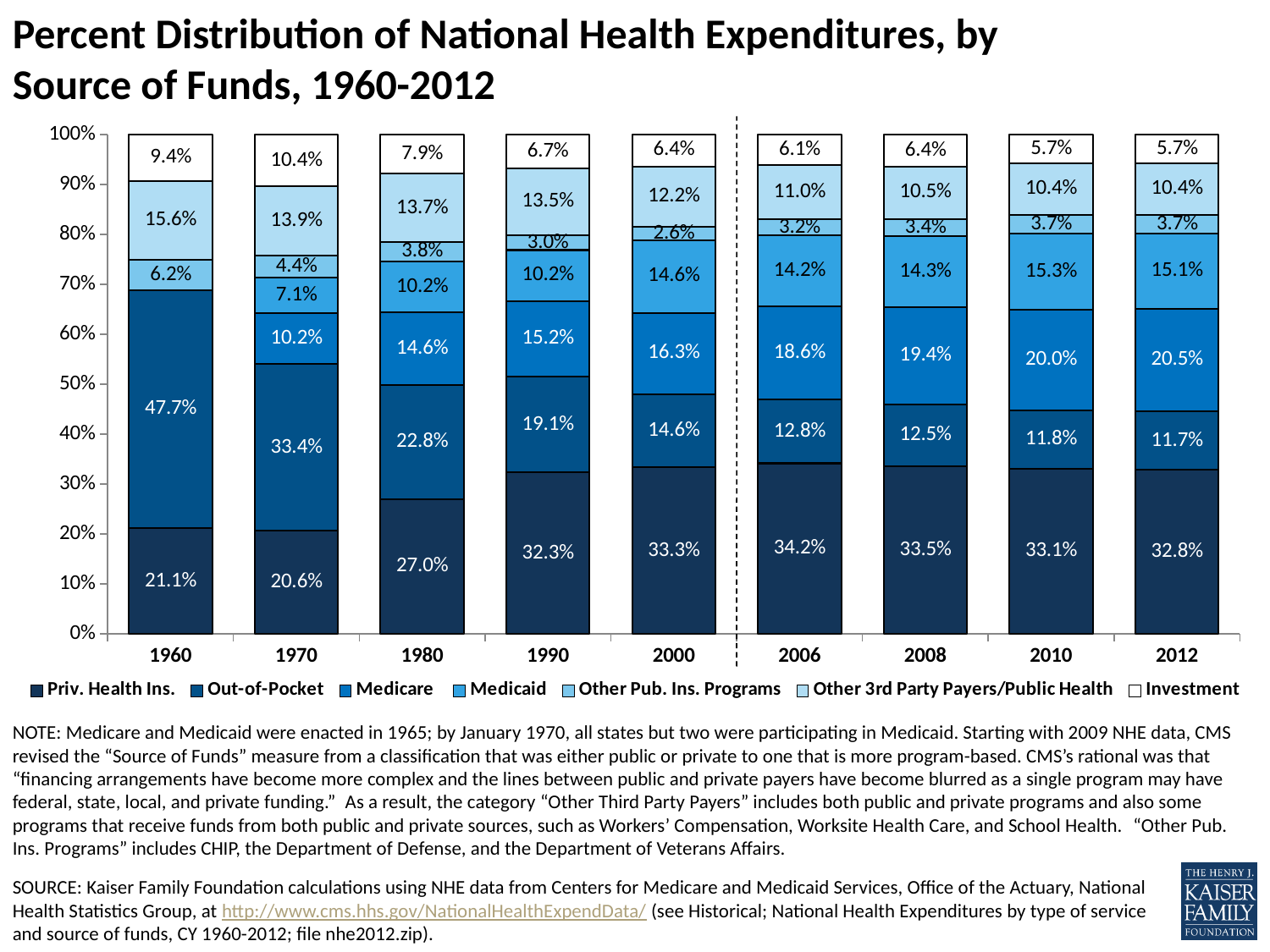
How many years are shown along the x axis of the chart? 9 In which year is the Priv. Health Ins. share the lowest? 1970 What is the Investment share in 1970? 10.4% How many series does the chart's legend list? 7 Which is larger in 2000: the Priv. Health Ins. share or the Out-of-Pocket share? Priv. Health Ins. What is the difference between the Out-of-Pocket share in 1960 and in 2012? 36.0 percentage points Does the Out-of-Pocket share rise or fall from 1960 to 2012? Fall What is the Priv. Health Ins. share in 2012? 32.8% What is the Medicare share in 2012? 20.5% In which year is the Out-of-Pocket share the highest? 1960 What type of chart is shown on the slide? Stacked bar chart What is the Out-of-Pocket share of national health expenditures in 1960? 47.7%